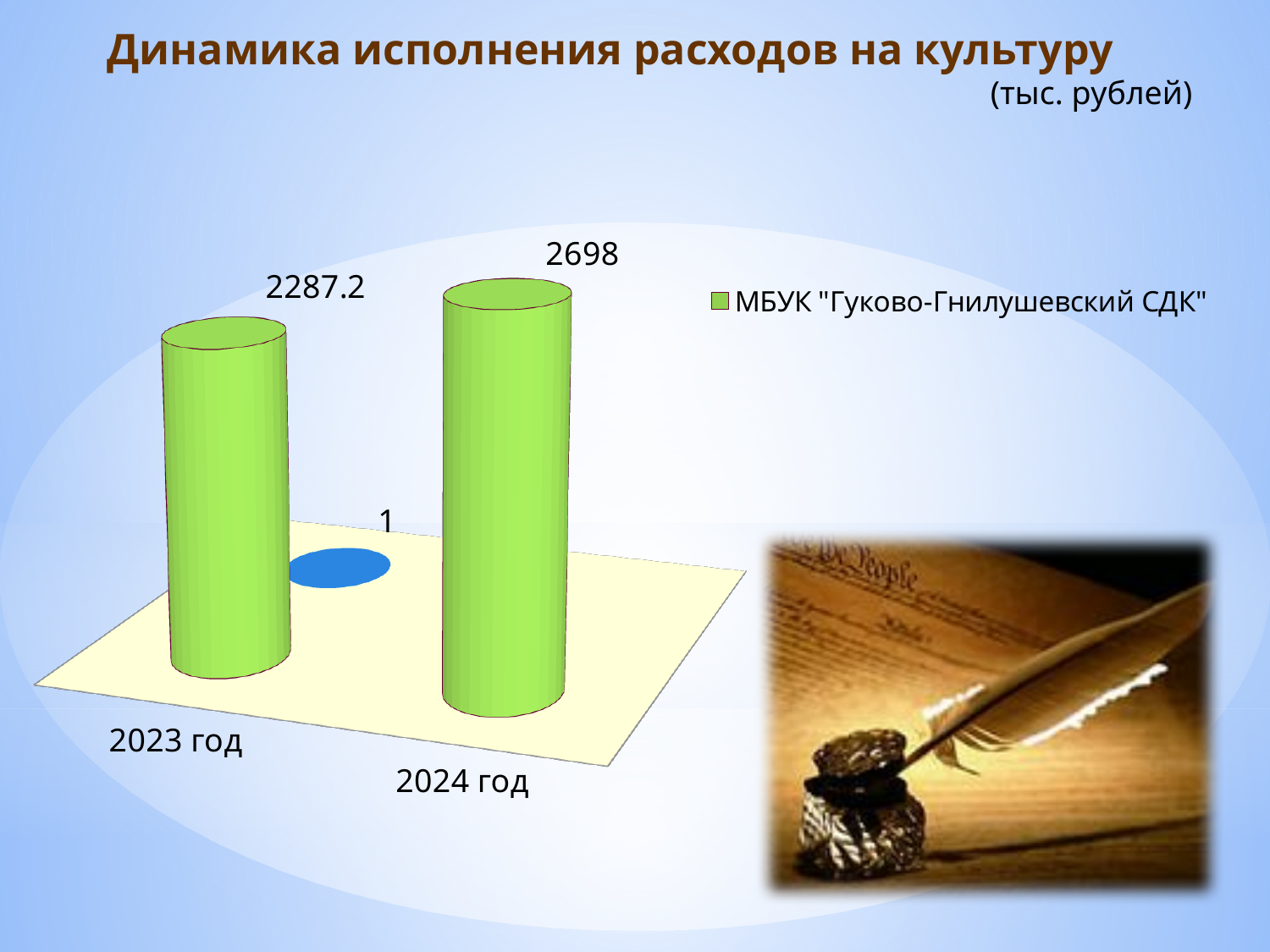
Which is larger, the value for 2023 год or the value for 2024 год? 2024 год What is the title of the chart on the slide? Динамика исполнения расходов на культуру How many series does the legend list? 1 Which year has the highest value? 2024 год What is the value for 2024 год? 2698 How many year categories are shown on the chart? 2 What series name is listed in the legend? МБУК "Гуково-Гнилушевский СДК" Do the values rise or fall from 2023 год to 2024 год? Rise What is the value for 2023 год? 2287.2 What kind of chart is shown on the slide? Bar chart What is the difference between the values for 2024 год and 2023 год? 410.8 Which year has the lowest value? 2023 год